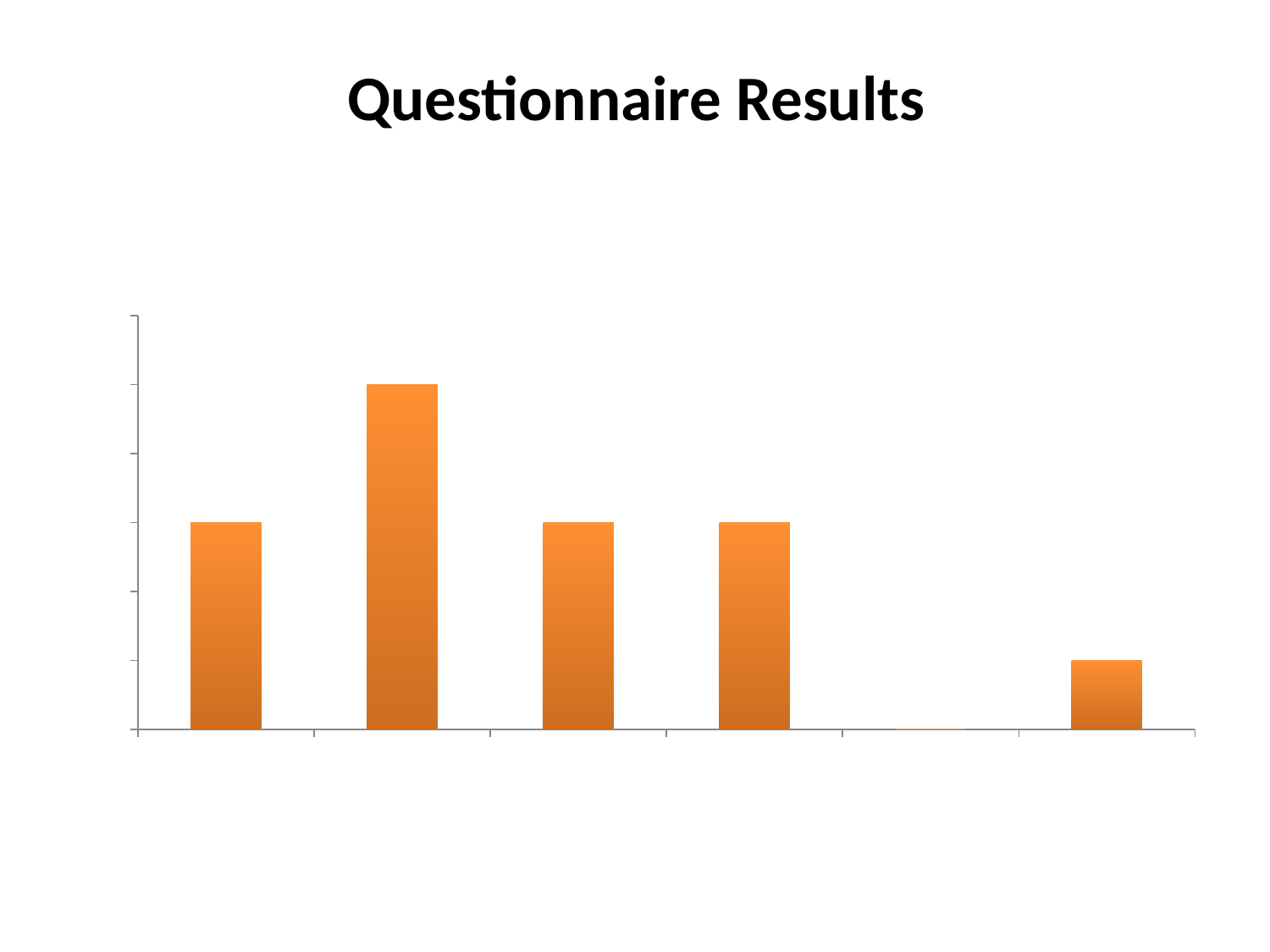
Is the second bar from the left taller or shorter than the first bar? taller Which of the drawn bars is the shortest? the rightmost bar Do the bar heights consistently rise from left to right across the chart? no What colour are the bars in the chart? orange What kind of chart is shown on the slide? bar chart Which bar is the tallest in the chart, counting from the left? the second bar How many bars are drawn in the chart? 5 What is the title of the slide? Questionnaire Results Is the rightmost bar taller or shorter than the fourth bar from the left? shorter